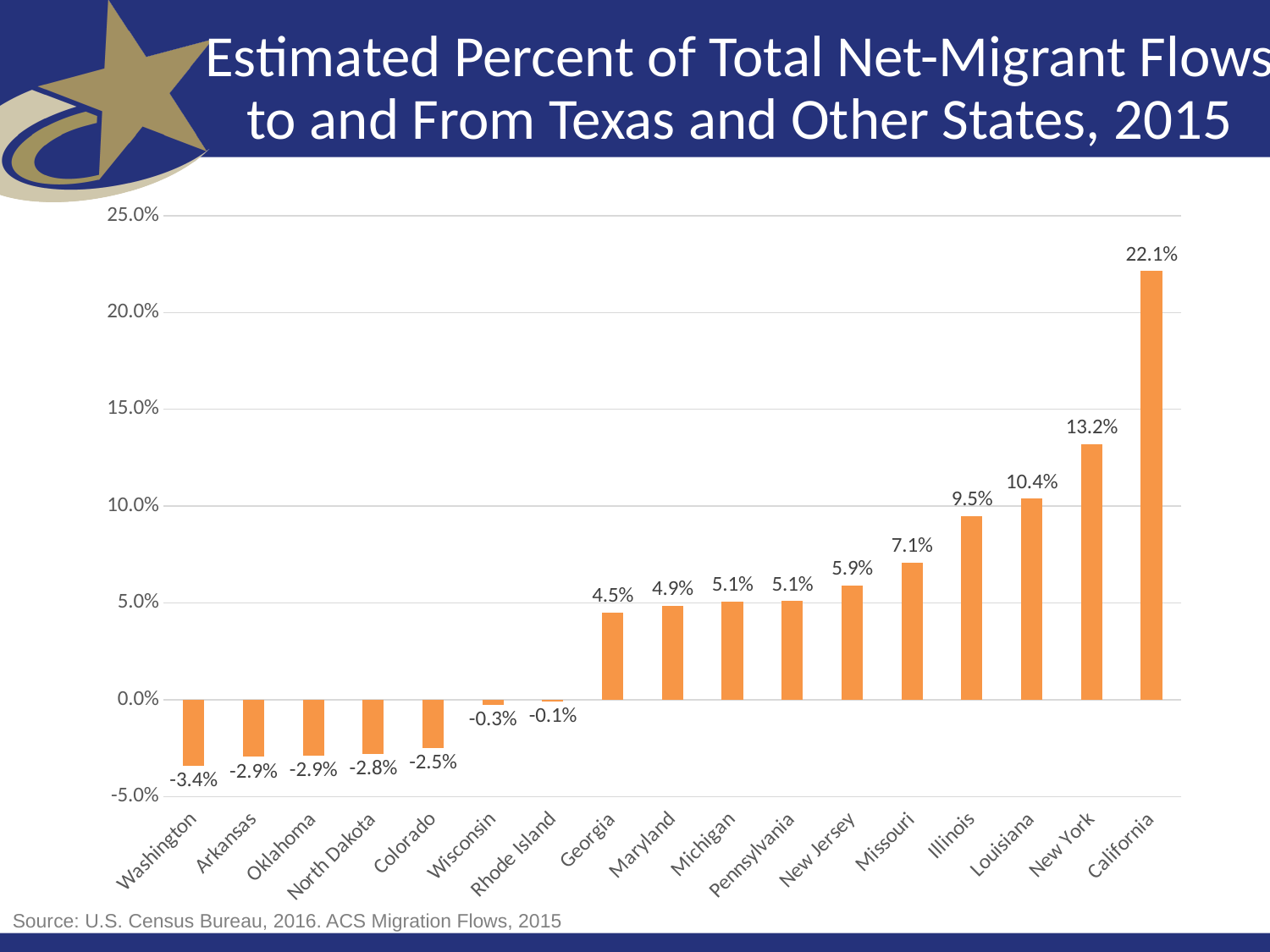
Which state has the lowest value? Washington Is the value for New York greater or less than 10.0%? greater Which state has the highest value? California What kind of chart is shown on the slide? bar chart Which is larger, the value for New Jersey or the value for Georgia? New Jersey How many states are shown on the x axis? 17 What is the difference between the values for California and New York? 8.9% What is the value for Missouri? 7.1% What is the difference between the values for Louisiana and Illinois? 0.9% What is the value for California? 22.1% What is the value for Washington? -3.4% Do the values rise or fall moving from left to right along the x axis? rise